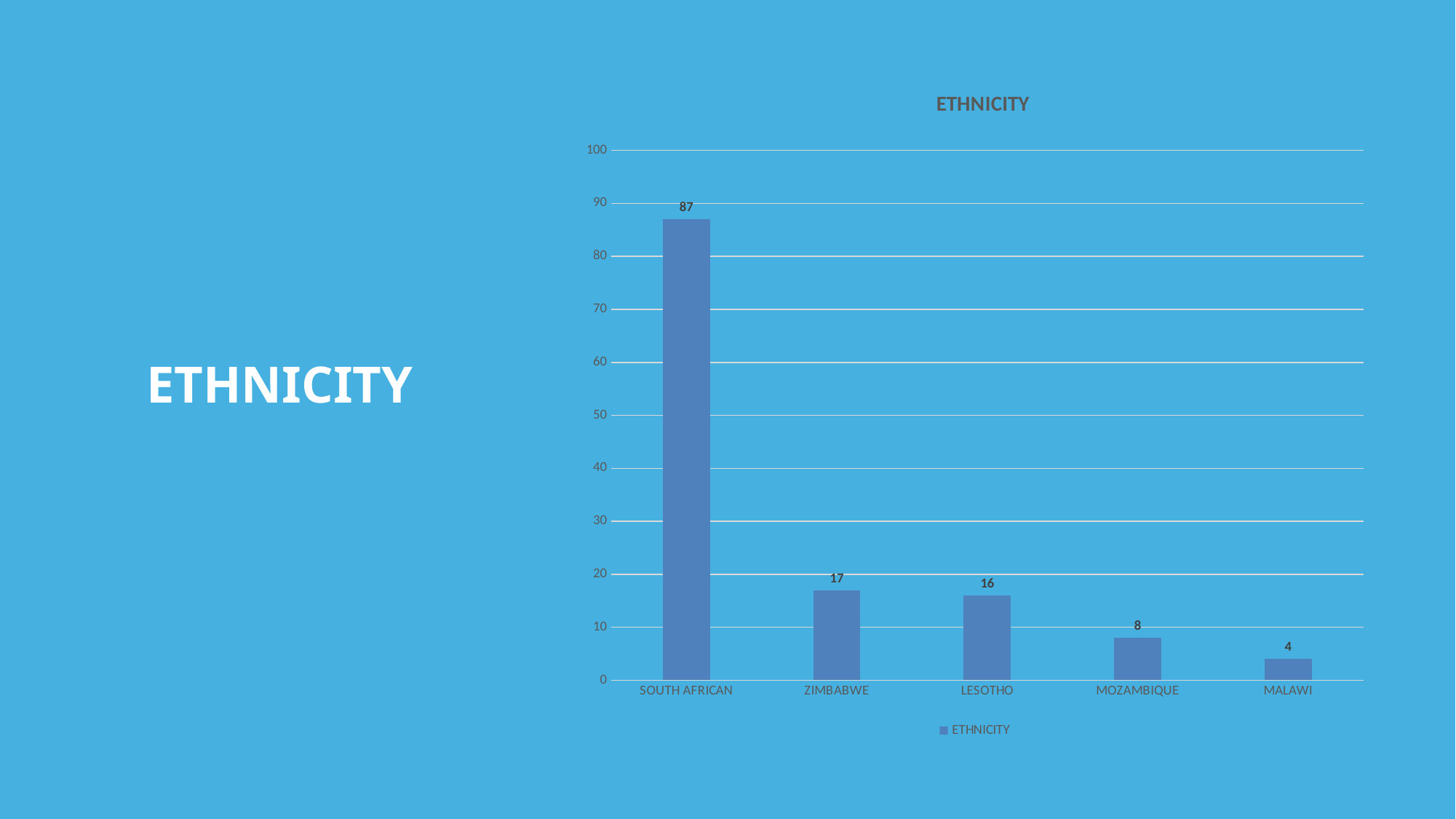
What kind of chart is shown on the slide? bar chart What is the title of the chart? ETHNICITY What is the value for SOUTH AFRICAN? 87 How many categories are shown on the x axis? 5 Which category has the lowest value? MALAWI What is the value for MOZAMBIQUE? 8 Is the value for ZIMBABWE greater or less than 20? less What is the value for ZIMBABWE? 17 What is the difference between the values for MOZAMBIQUE and MALAWI? 4 Which category has the highest value? SOUTH AFRICAN What is the difference between the values for SOUTH AFRICAN and ZIMBABWE? 70 Which is larger, the value for LESOTHO or the value for MOZAMBIQUE? LESOTHO